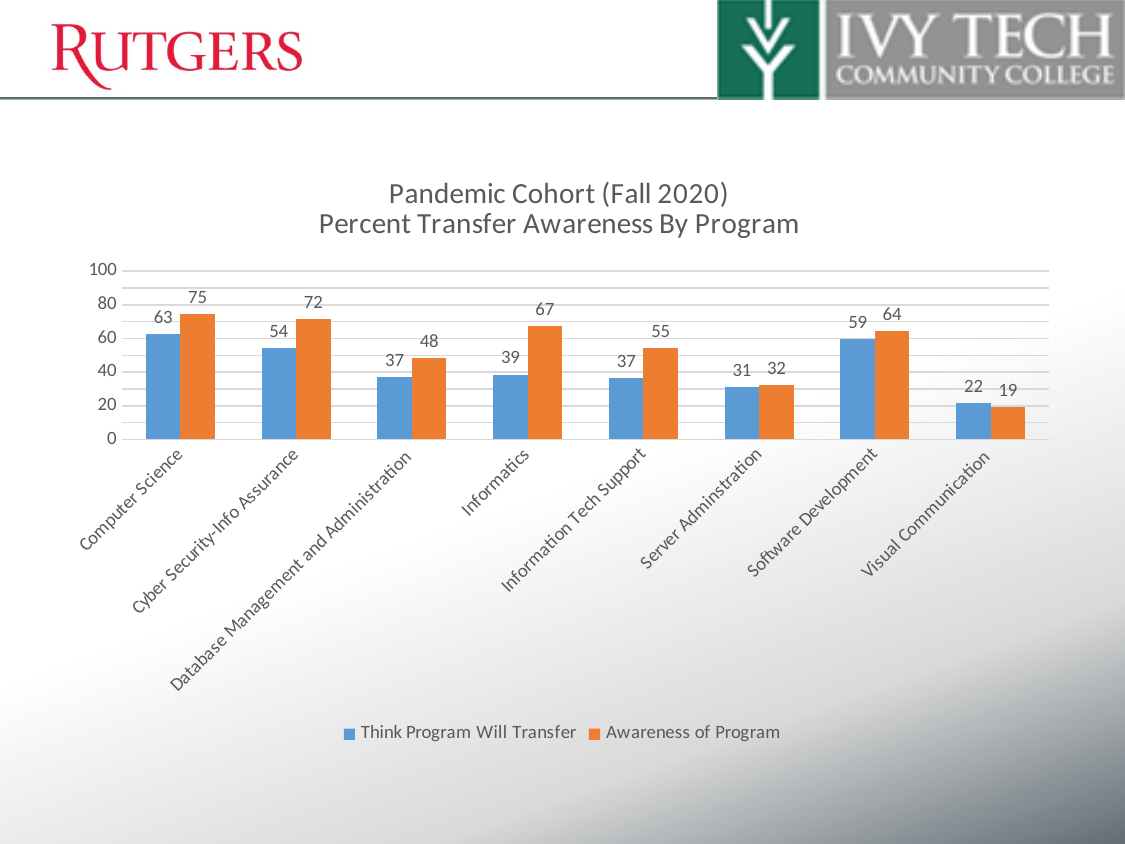
How many series does the legend list? 2 What is the title of the chart? Pandemic Cohort (Fall 2020) Percent Transfer Awareness By Program Which program has the lowest Think Program Will Transfer value? Visual Communication For Visual Communication, which is larger: Think Program Will Transfer or Awareness of Program? Think Program Will Transfer What is the difference between Awareness of Program for Computer Science and Awareness of Program for Visual Communication? 56 What is the value for Think Program Will Transfer for Software Development? 59 What is the difference between Awareness of Program and Think Program Will Transfer for Informatics? 28 What is the value for Awareness of Program for Computer Science? 75 How many programs are shown on the x axis? 8 What kind of chart is shown on the slide? Bar chart What is the value for Think Program Will Transfer for Informatics? 39 Which program has the highest Awareness of Program value? Computer Science